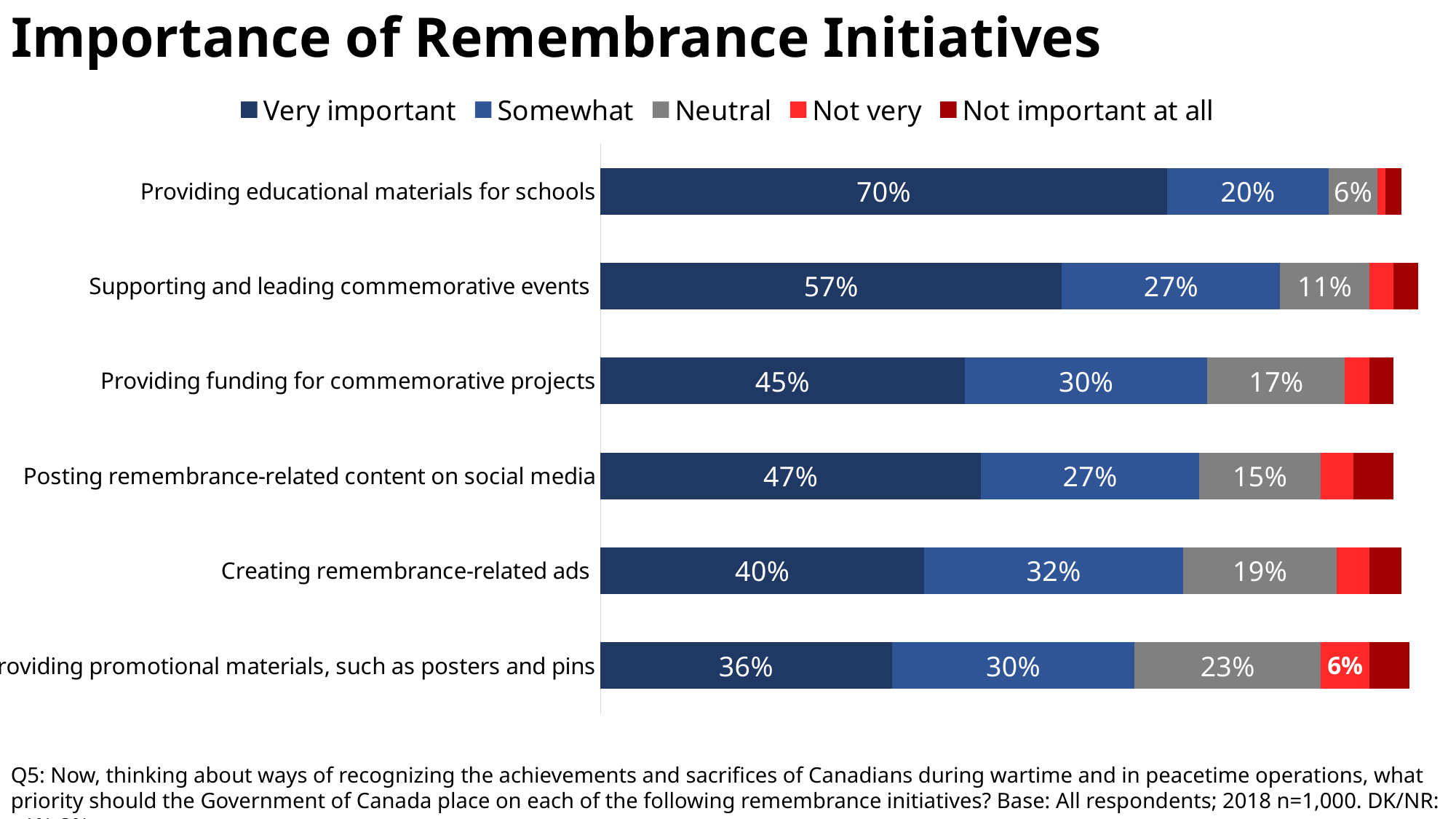
What is the Neutral value for providing funding for commemorative projects? 17% How many series does the legend list? 5 Which initiative has the highest Very important percentage? Providing educational materials for schools How many initiatives are shown in the chart? 6 Which initiative has the highest Neutral percentage? Providing promotional materials, such as posters and pins What is the Somewhat value for creating remembrance-related ads? 32% Which has a larger Very important percentage: posting remembrance-related content on social media or providing funding for commemorative projects? Posting remembrance-related content on social media What kind of chart is shown on the slide? Stacked bar chart What percentage of respondents rated providing educational materials for schools as very important? 70% Which initiative has the lowest Very important percentage? Providing promotional materials, such as posters and pins What is the difference between the Very important percentages for providing educational materials for schools and supporting and leading commemorative events? 13% What is the Not very value for providing promotional materials, such as posters and pins? 6%